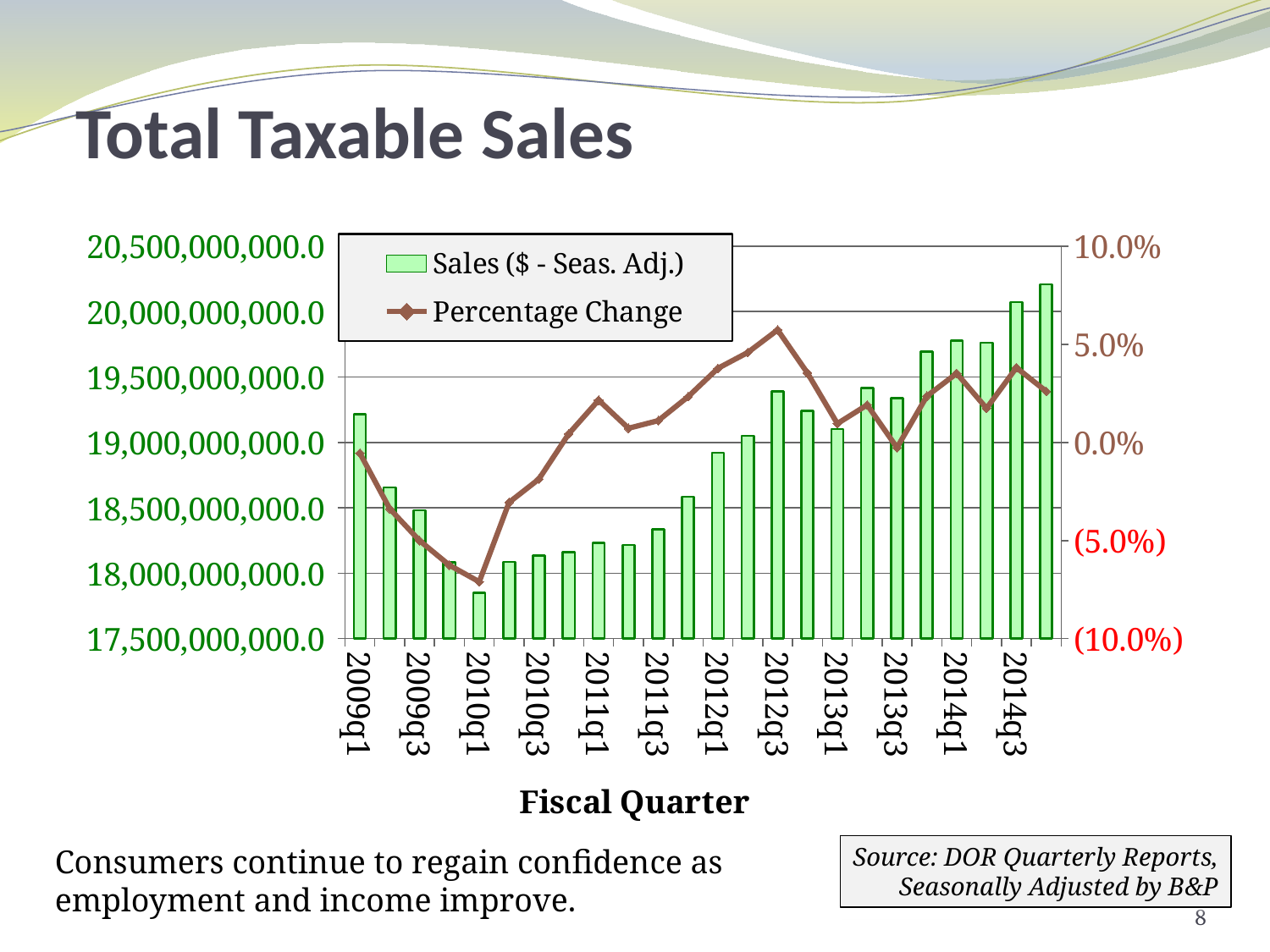
Which labeled fiscal quarter has the lowest Percentage Change value? 2010q1 Which labeled fiscal quarter has the highest Percentage Change value? 2012q3 How many bars are plotted in the chart? 24 What are the two series named in the legend? Sales ($ - Seas. Adj.) and Percentage Change Is the Sales value for 2010q1 greater or less than 18,000,000,000.0? less Which has the larger Sales value, 2009q1 or 2010q1? 2009q1 Which labeled fiscal quarter has the lowest Sales bar? 2010q1 What kind of chart is shown on the slide? A combination bar and line chart How many series does the legend list? 2 Is the Sales value for 2009q1 greater or less than 19,000,000,000.0? greater Is the Percentage Change for 2012q3 greater or less than 5.0%? greater What is the title of the x axis? Fiscal Quarter